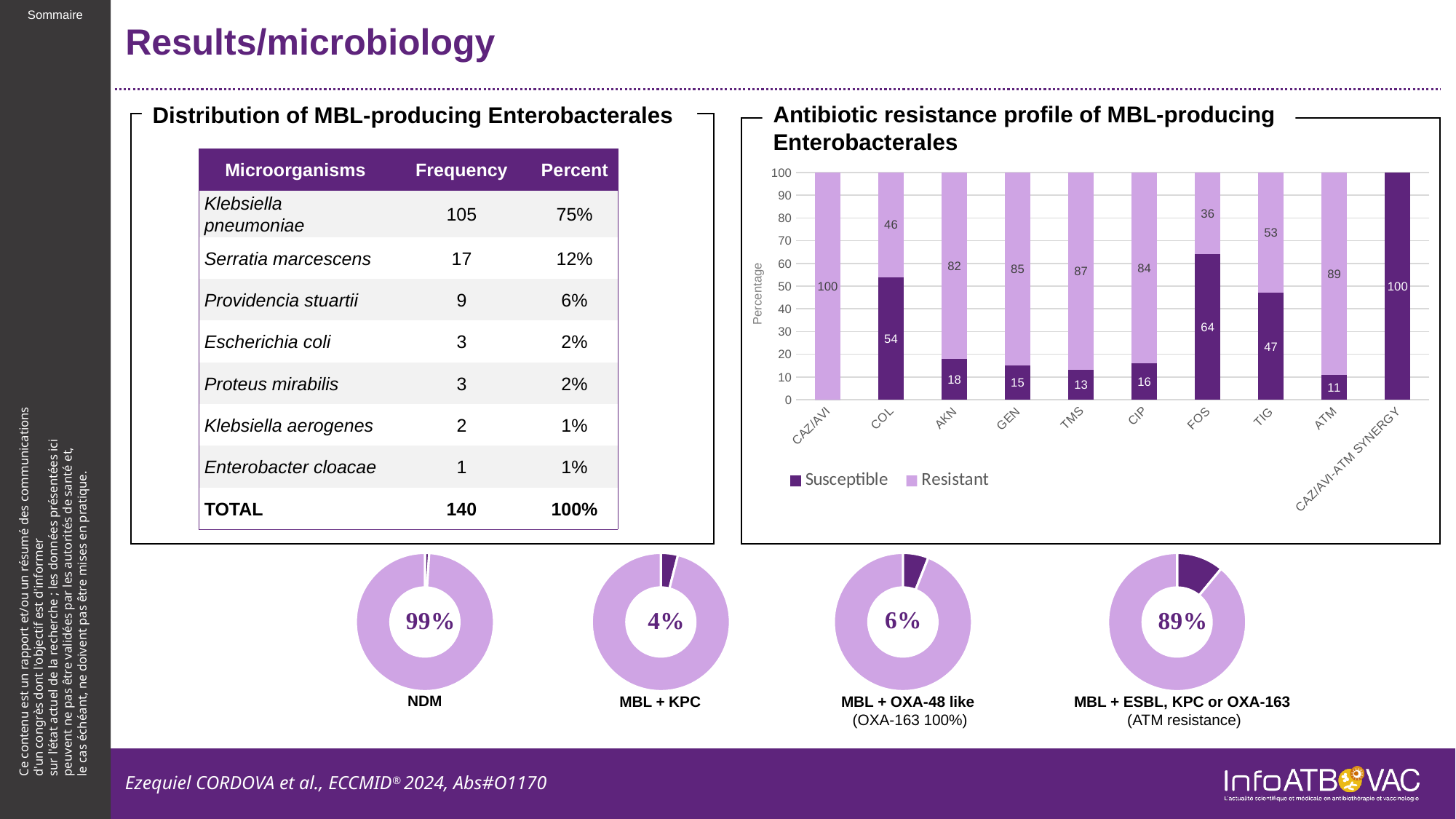
How many series does the legend of the 'Antibiotic resistance profile of MBL-producing Enterobacterales' chart list? 2 What percentage is shown in the donut chart labelled 'MBL + KPC'? 4% In the 'Antibiotic resistance profile of MBL-producing Enterobacterales' chart, what is the difference between the Resistant values for ATM and TIG? 36 In the 'Antibiotic resistance profile of MBL-producing Enterobacterales' chart, what is the Resistant value for TMS? 87 In the 'Antibiotic resistance profile of MBL-producing Enterobacterales' chart, is the Susceptible value larger for FOS or for TIG? FOS In the 'Antibiotic resistance profile of MBL-producing Enterobacterales' chart, what is the total of the stacked bar for AKN? 100 In the 'Antibiotic resistance profile of MBL-producing Enterobacterales' chart, how many antibiotics are shown on the x axis? 10 In the 'Antibiotic resistance profile of MBL-producing Enterobacterales' chart, which antibiotic has the lowest labelled Resistant value? FOS In the 'Antibiotic resistance profile of MBL-producing Enterobacterales' chart, which antibiotic has the highest Susceptible value? CAZ/AVI-ATM SYNERGY In the 'Antibiotic resistance profile of MBL-producing Enterobacterales' chart, what is the Susceptible value for COL? 54 What kind of chart is the 'Antibiotic resistance profile of MBL-producing Enterobacterales' chart? Stacked bar chart What percentage is shown in the donut chart labelled 'NDM'? 99%